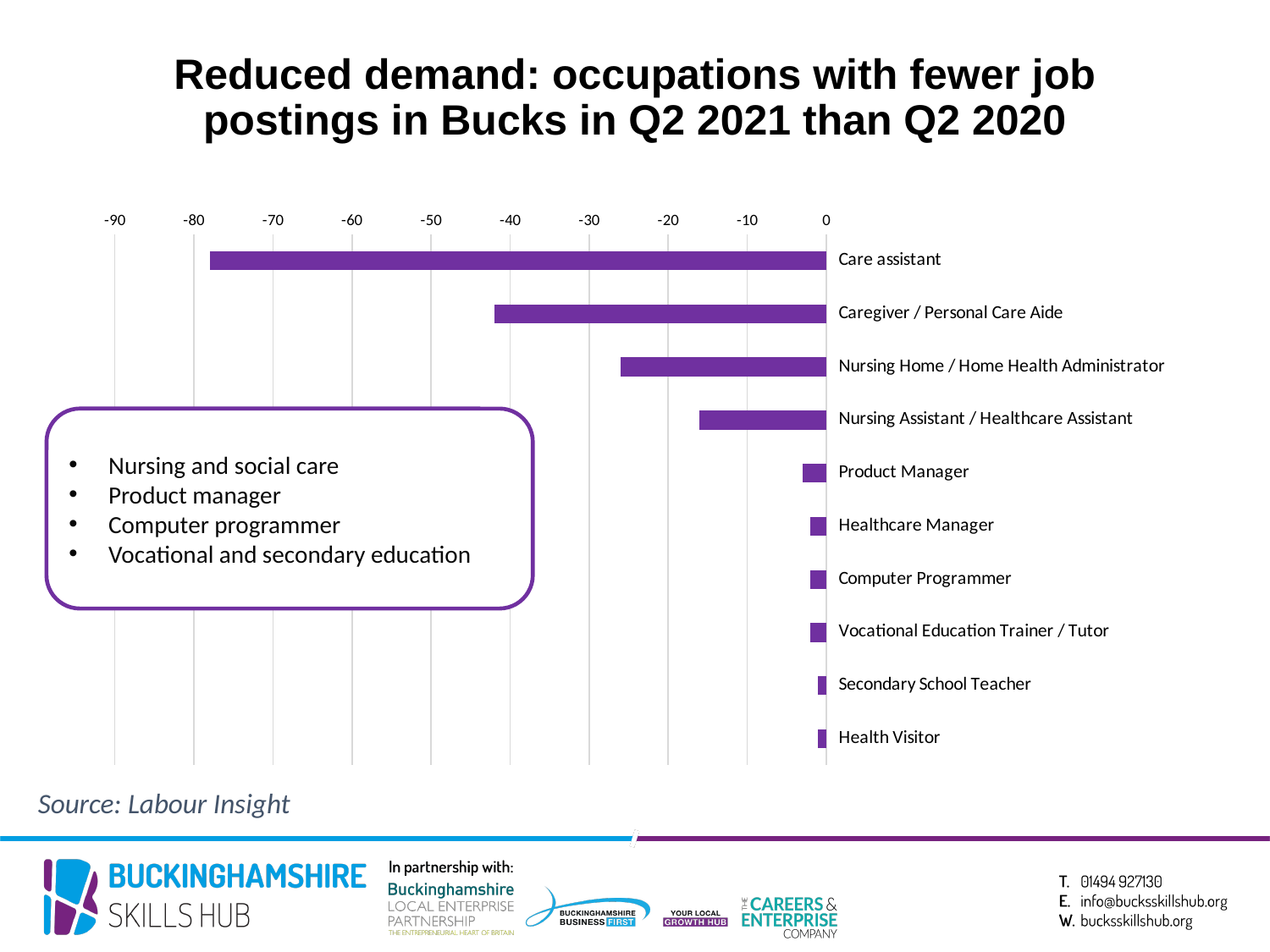
What is the lowest value shown on the chart's horizontal axis? -90 Which shows a larger decrease in job postings: Care assistant or Caregiver / Personal Care Aide? Care assistant Is the value for Care assistant greater or less than -70? less Is the value for Nursing Home / Home Health Administrator greater or less than -30? greater Is the value for Product Manager greater or less than -10? greater Which shows a larger decrease in job postings: Nursing Home / Home Health Administrator or Nursing Assistant / Healthcare Assistant? Nursing Home / Home Health Administrator How many occupations are plotted in the chart? 10 Which occupation shows the largest reduction in job postings? Care assistant What kind of chart is shown on the slide? Bar chart What is the source cited for the chart data? Labour Insight